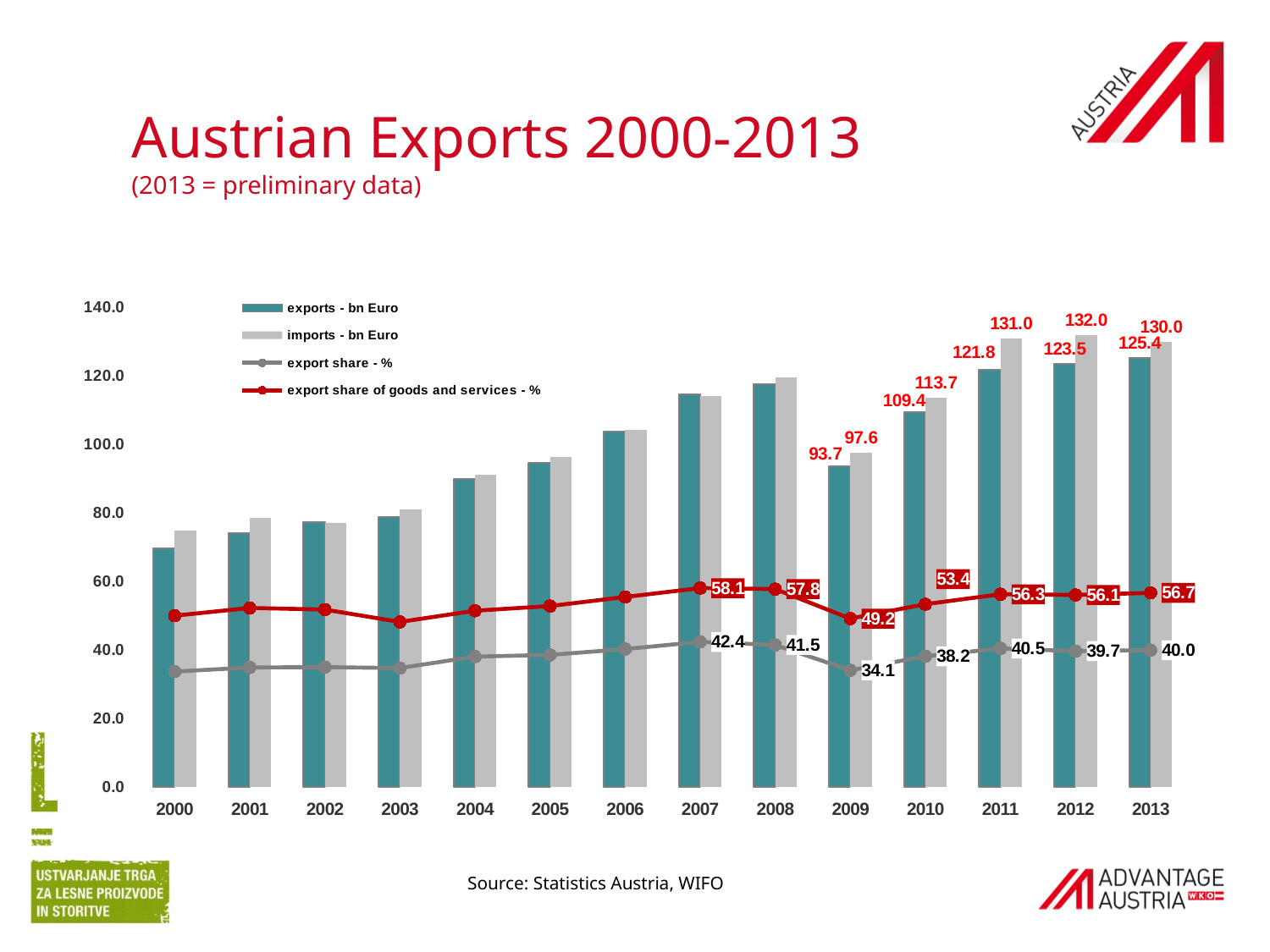
What is the value of imports (bn Euro) in 2012? 132.0 Is the value for exports in 2000 greater or less than 80.0? less How much did the export share of goods and services fall from 2008 to 2009 (percentage points)? 8.6 What is the value of exports (bn Euro) in 2011? 121.8 Is the value for exports in 2007 greater or less than 100.0? greater How many series does the legend list? 4 What is the export share of goods and services (%) in 2007? 58.1 By how much do imports exceed exports in 2011 (bn Euro)? 9.2 How many years are shown on the x axis of the chart? 14 In which year is the export share (%) at its lowest among the labelled values? 2009 What is the export share (%) in 2009? 34.1 Which year has higher exports, 2012 or 2013? 2013